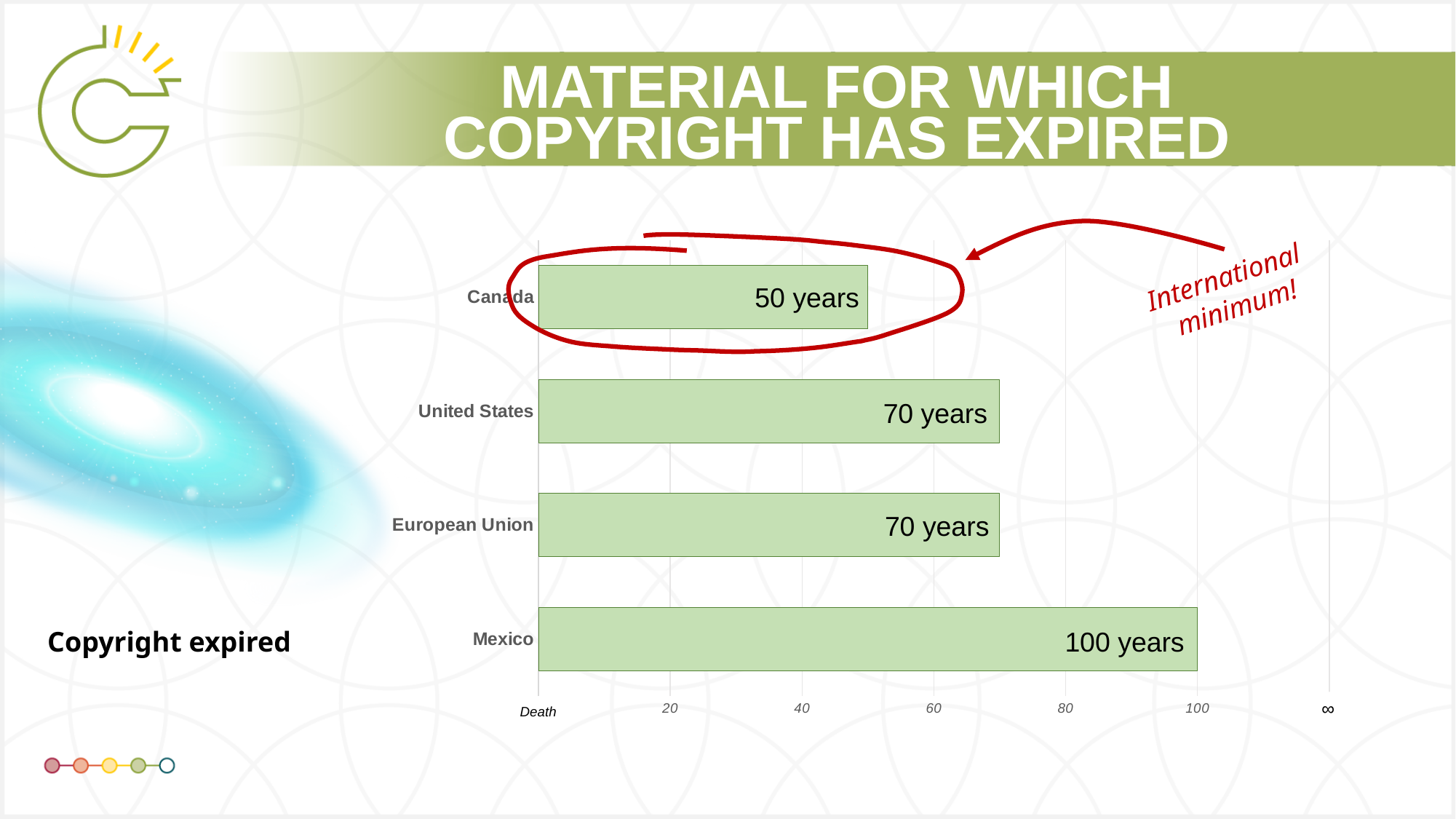
How many years longer is Mexico's copyright term than Canada's? 50 years Which category's bar is circled in red with the annotation 'International minimum!'? Canada What is the copyright term shown for Mexico? 100 years How many categories are shown in the chart? 4 What is the copyright term shown for the European Union? 70 years Which category has the shortest copyright term? Canada What is the copyright term shown for Canada? 50 years What is the copyright term shown for the United States? 70 years Which category has the longest copyright term? Mexico What kind of chart is shown on the slide? Bar chart Which has a longer copyright term, Canada or the United States? United States How many years longer is the United States' copyright term than Canada's? 20 years